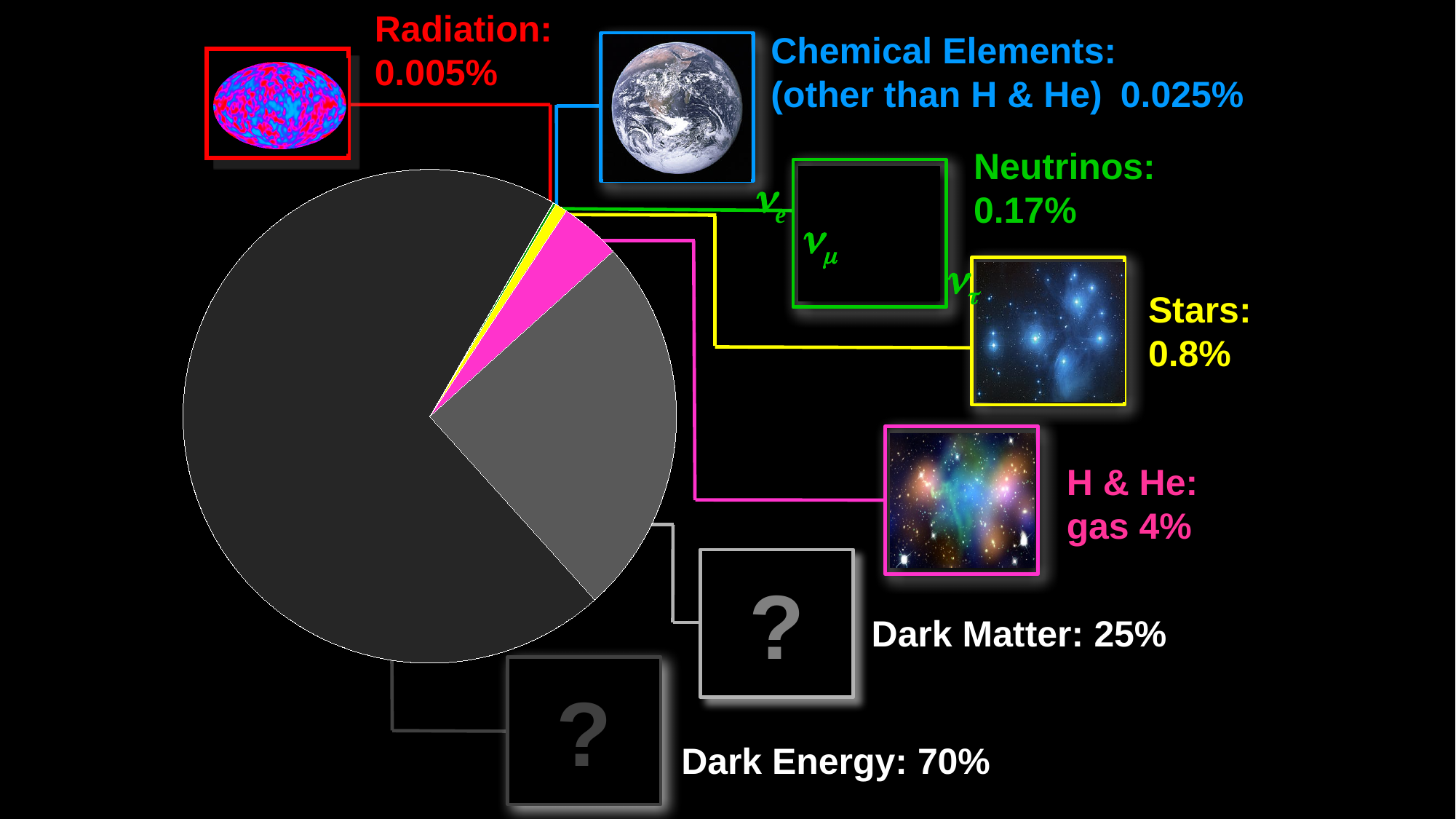
How many components are labelled on the pie chart? 7 What is the difference between the Dark Energy and Dark Matter percentages? 45% What percentage does the pie chart give for Neutrinos? 0.17% What kind of chart is shown on the slide? pie chart Which component has the smallest share of the pie chart? Radiation What percentage does the pie chart give for Radiation? 0.005% What percentage does the pie chart give for Stars? 0.8% Which is larger, the share for Stars or the share for H & He gas? H & He gas What percentage does the pie chart give for H & He gas? 4% Which component has the largest share of the pie chart? Dark Energy What percentage does the pie chart give for Dark Matter? 25% What percentage does the pie chart give for Dark Energy? 70%